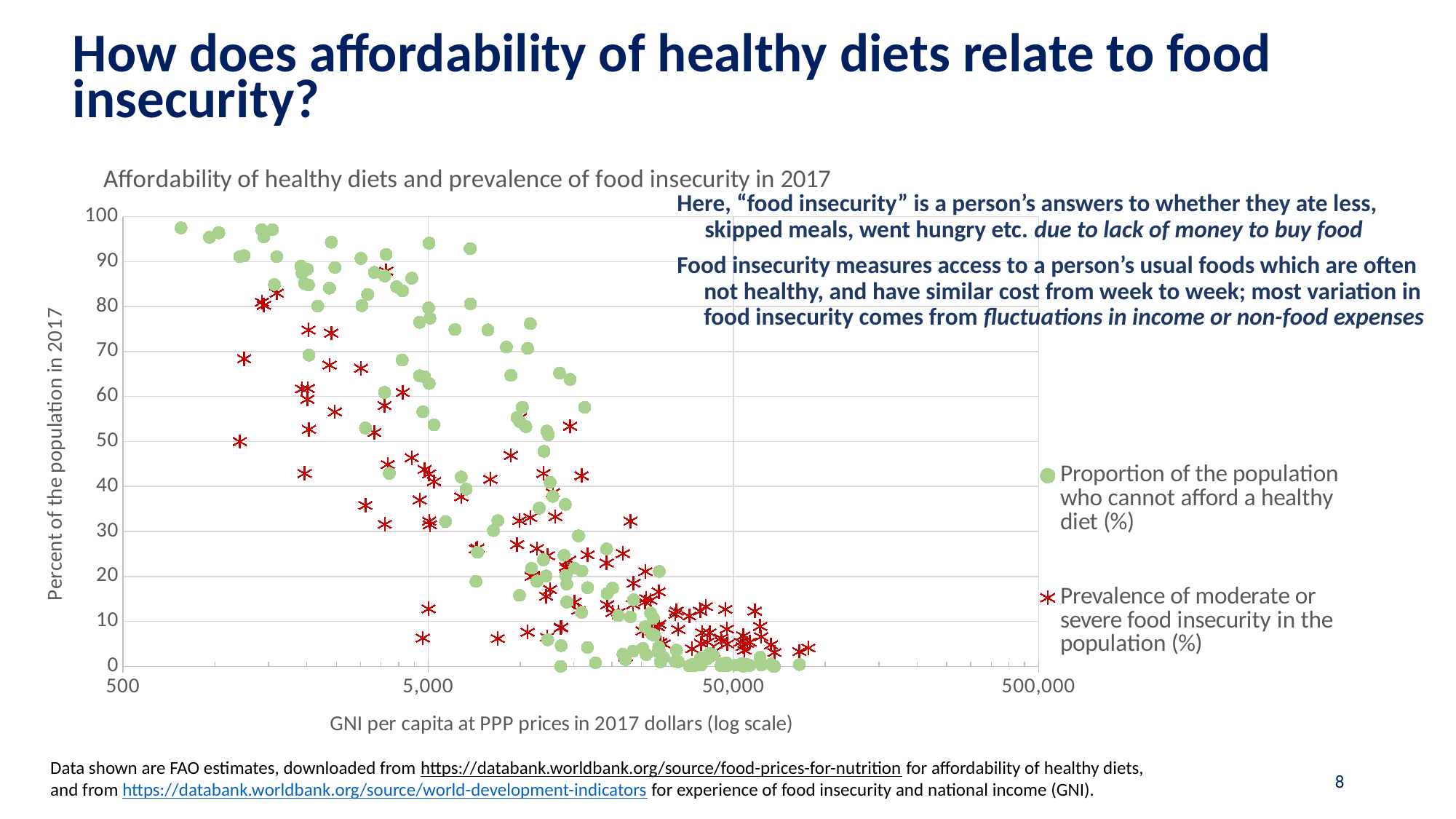
What is the highest value shown on the chart's y axis? 100 What is the label of the chart's x axis? GNI per capita at PPP prices in 2017 dollars (log scale) What is the lowest value shown on the chart's x axis? 500 How many series does the chart's legend list? 2 Which series is plotted with green circle markers? Proportion of the population who cannot afford a healthy diet (%) What kind of chart is shown on the slide? Scatter chart What is the title of the chart? Affordability of healthy diets and prevalence of food insecurity in 2017 As GNI per capita increases along the x axis, do the values for the prevalence of moderate or severe food insecurity generally rise or fall? Fall As GNI per capita increases along the x axis, do the values for the proportion of the population who cannot afford a healthy diet generally rise or fall? Fall What is the highest value shown on the chart's x axis? 500,000